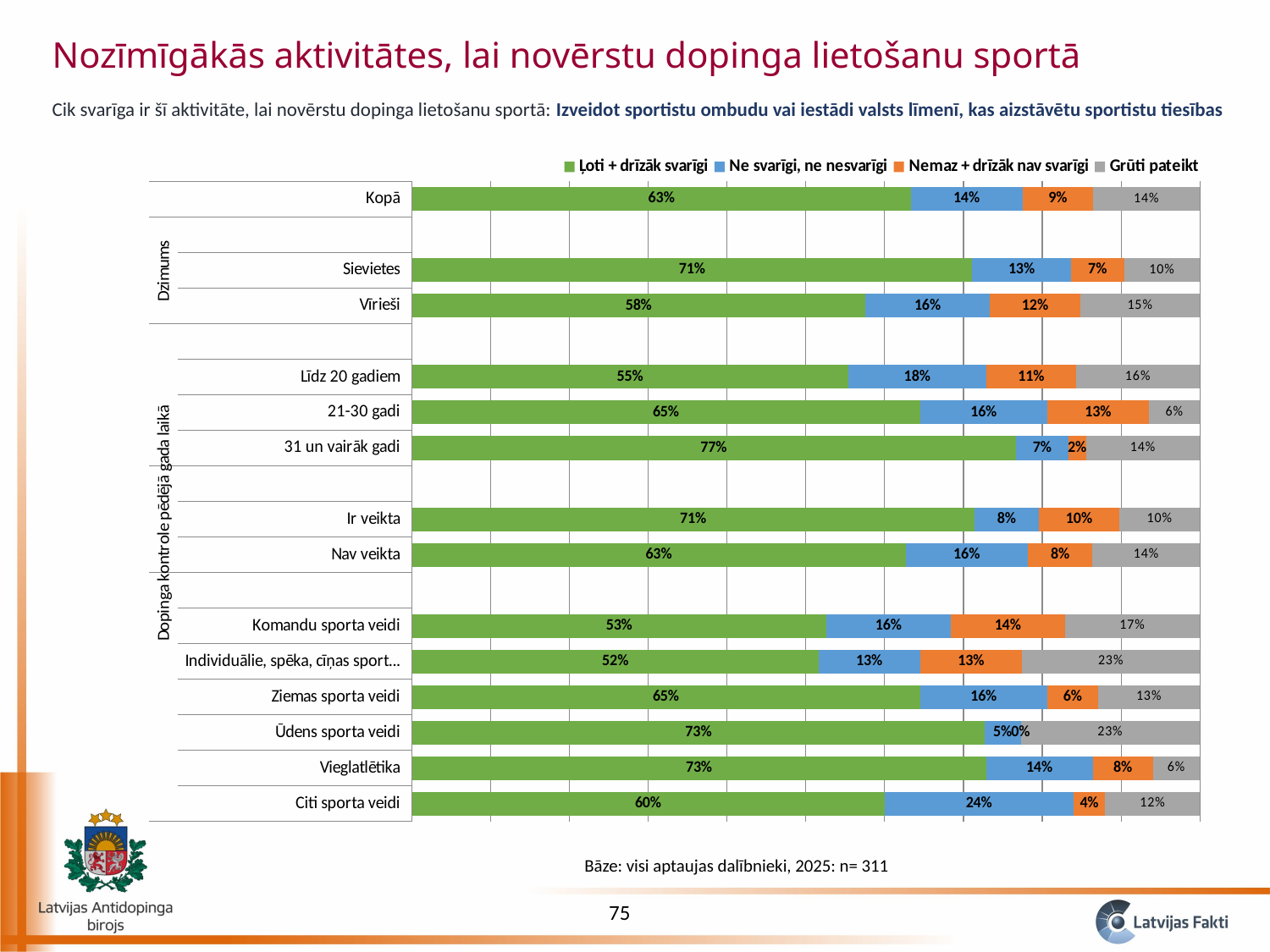
Which category has the highest "Ļoti + drīzāk svarīgi" value? 31 un vairāk gadi Which category has the highest "Ne svarīgi, ne nesvarīgi" value? Citi sporta veidi How many categories are plotted in the chart? 14 How many series does the legend list? 4 What is the base (n) stated below the chart? n= 311 What is the "Nemaz + drīzāk nav svarīgi" value for 31 un vairāk gadi? 2% What kind of chart is shown on the slide? stacked bar chart What is the difference between the "Ļoti + drīzāk svarīgi" values for Sievietes and Vīrieši? 13 percentage points What is the "Ļoti + drīzāk svarīgi" value for Kopā? 63% What is the "Grūti pateikt" value for Individuālie, spēka, cīņas sport...? 23% What is the "Ne svarīgi, ne nesvarīgi" value for Citi sporta veidi? 24% Which has a larger "Nemaz + drīzāk nav svarīgi" value, Komandu sporta veidi or Ziemas sporta veidi? Komandu sporta veidi